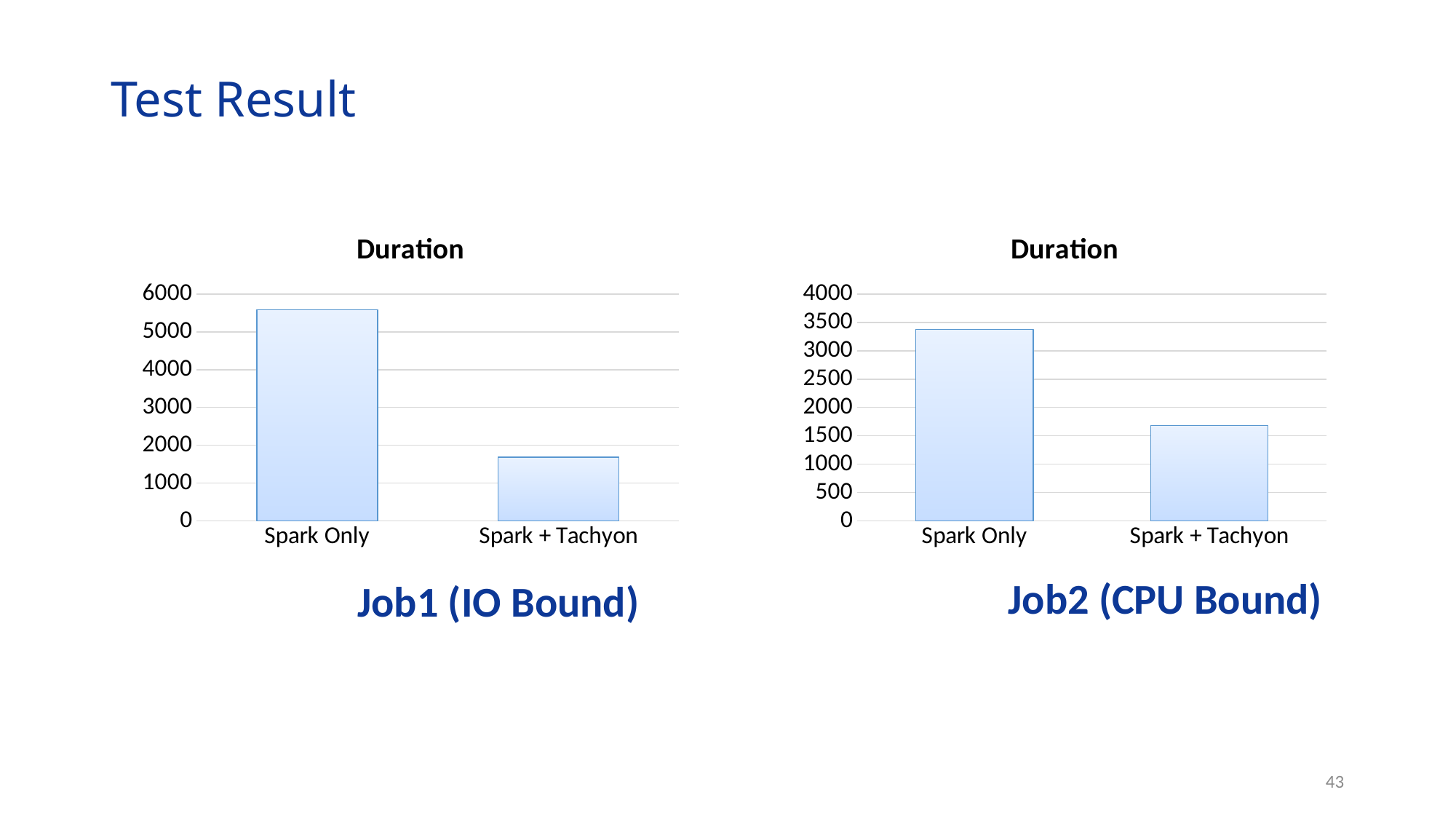
What is the title of the Job1 (IO Bound) chart? Duration In the Job1 (IO Bound) chart, which category has the highest duration? Spark Only In the Job1 (IO Bound) chart, is the value for Spark + Tachyon greater or less than 2000? less In the Job1 (IO Bound) chart, which category has the lowest duration? Spark + Tachyon In the Job2 (CPU Bound) chart, which category has the lowest duration? Spark + Tachyon In the Job2 (CPU Bound) chart, is the value for Spark + Tachyon greater or less than 2000? less In the Job2 (CPU Bound) chart, is the value for Spark Only greater or less than 3000? greater How many categories are shown in the Job1 (IO Bound) chart? 2 What kind of chart is the Job2 (CPU Bound) chart? bar chart In the Job2 (CPU Bound) chart, which is larger: Spark Only or Spark + Tachyon? Spark Only In the Job2 (CPU Bound) chart, which category has the highest duration? Spark Only